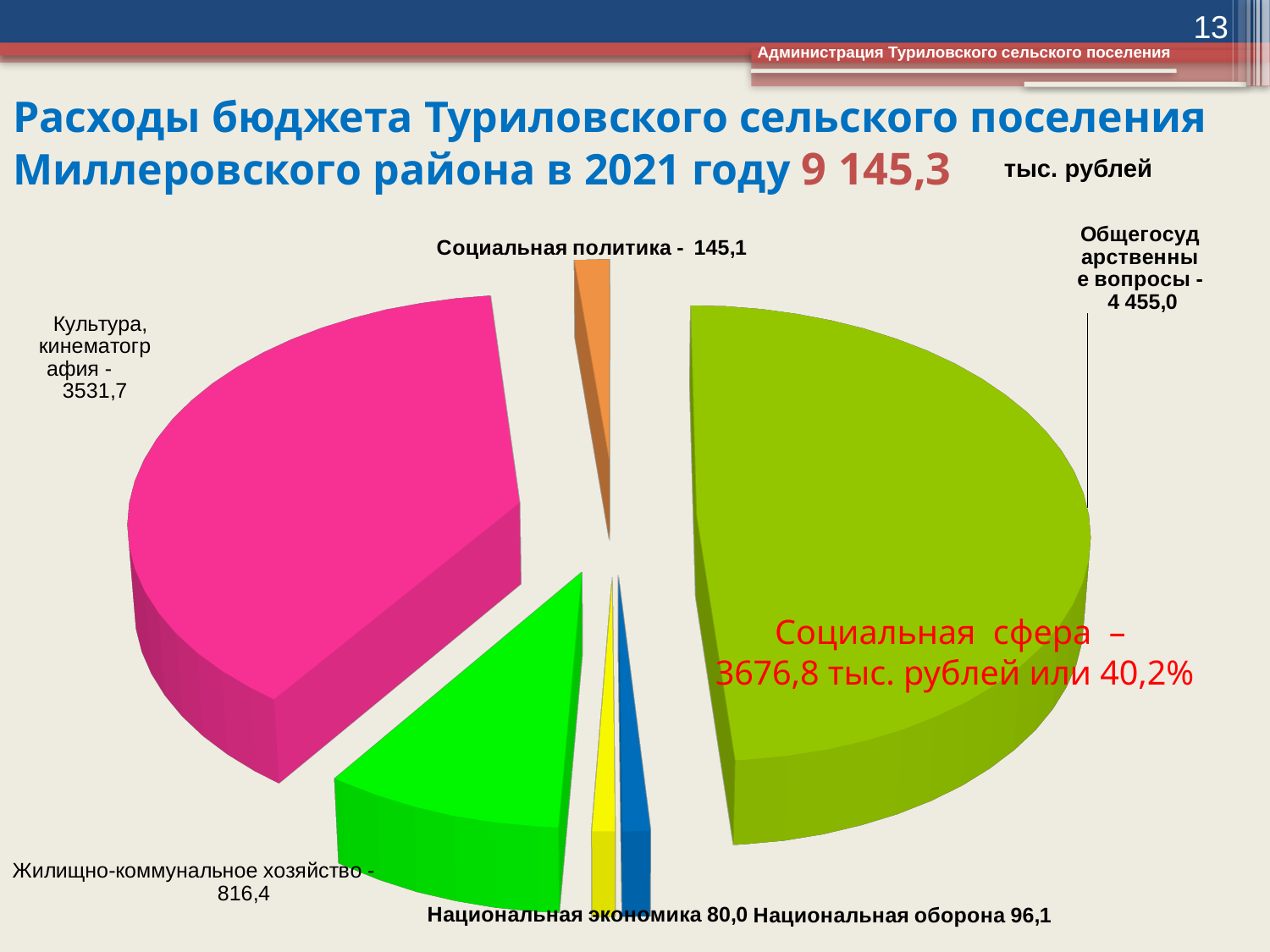
Which category has the largest slice of the pie? Общегосударственные вопросы What is the value for Общегосударственные вопросы? 4 455,0 What is the difference between Общегосударственные вопросы and Культура, кинематография? 923,3 How many slices does the pie chart have? 6 Which category has the smallest value in the pie chart? Национальная экономика What is the value for Культура, кинематография? 3531,7 What is the value for Национальная оборона? 96,1 What is the value for Жилищно-коммунальное хозяйство? 816,4 Which is larger: Национальная оборона or Национальная экономика? Национальная оборона What type of chart is shown on the slide? Pie chart What total budget expenditure figure is shown in the slide title? 9 145,3 тыс. рублей What is the value for Социальная политика? 145,1